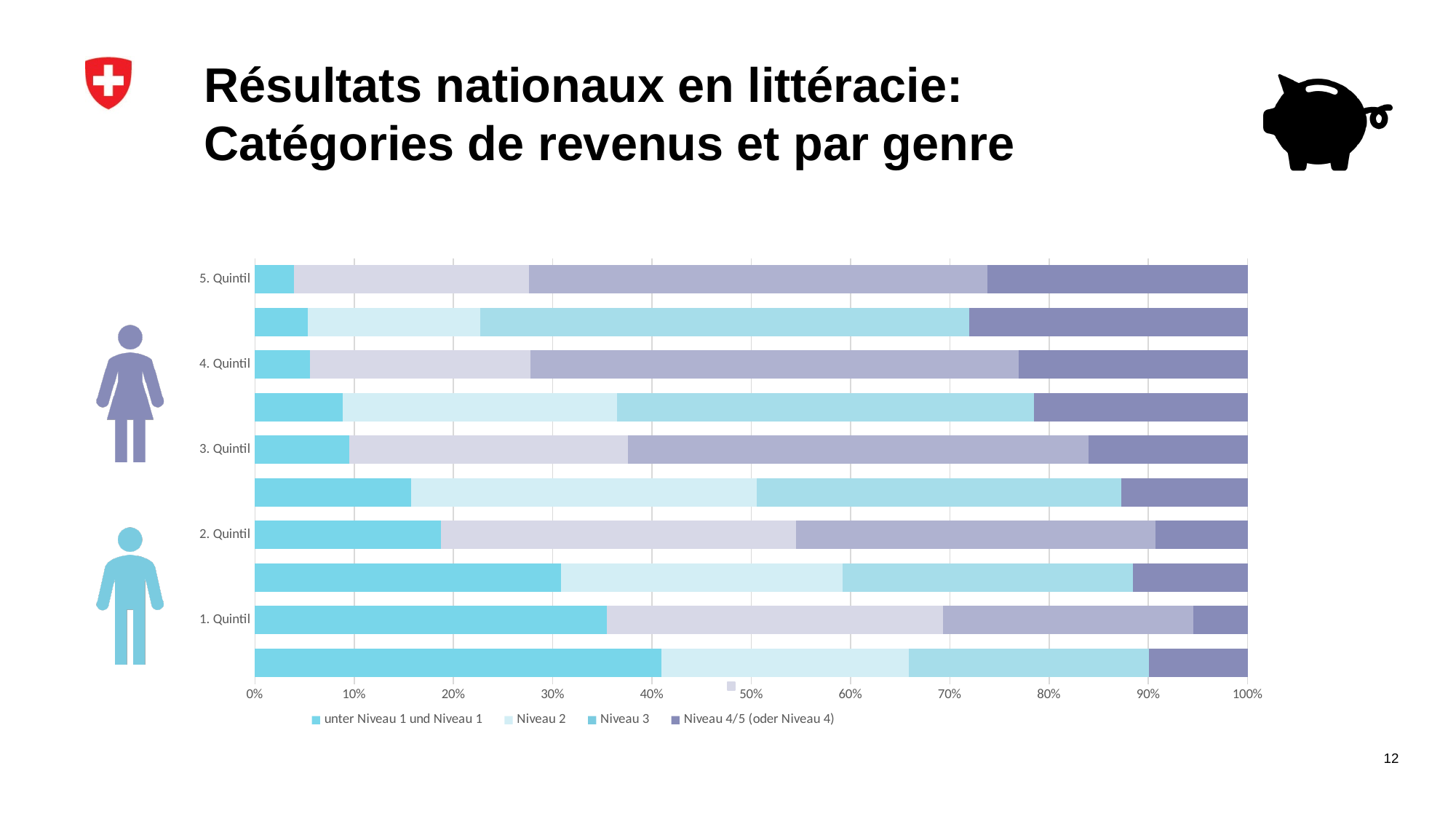
What is the last entry in the chart legend? Niveau 4/5 (oder Niveau 4) Is the 'unter Niveau 1 und Niveau 1' share in the upper bar for 5. Quintil greater or less than 10%? less Which quintile has the largest 'unter Niveau 1 und Niveau 1' share in its upper bar? 1. Quintil Is the 'unter Niveau 1 und Niveau 1' share in the upper bar for 1. Quintil greater or less than 30%? greater Does the 'unter Niveau 1 und Niveau 1' share in the upper bars rise or fall from 1. Quintil to 5. Quintil? fall What is the first entry in the chart legend? unter Niveau 1 und Niveau 1 How many series does the chart legend list? 4 What kind of chart is shown on the slide? Stacked bar chart Is the 'unter Niveau 1 und Niveau 1' share in the upper bar for 3. Quintil greater or less than 20%? less Which quintile has the smallest 'unter Niveau 1 und Niveau 1' share in its upper bar? 5. Quintil How many quintile categories are labelled on the vertical axis of the chart? 5